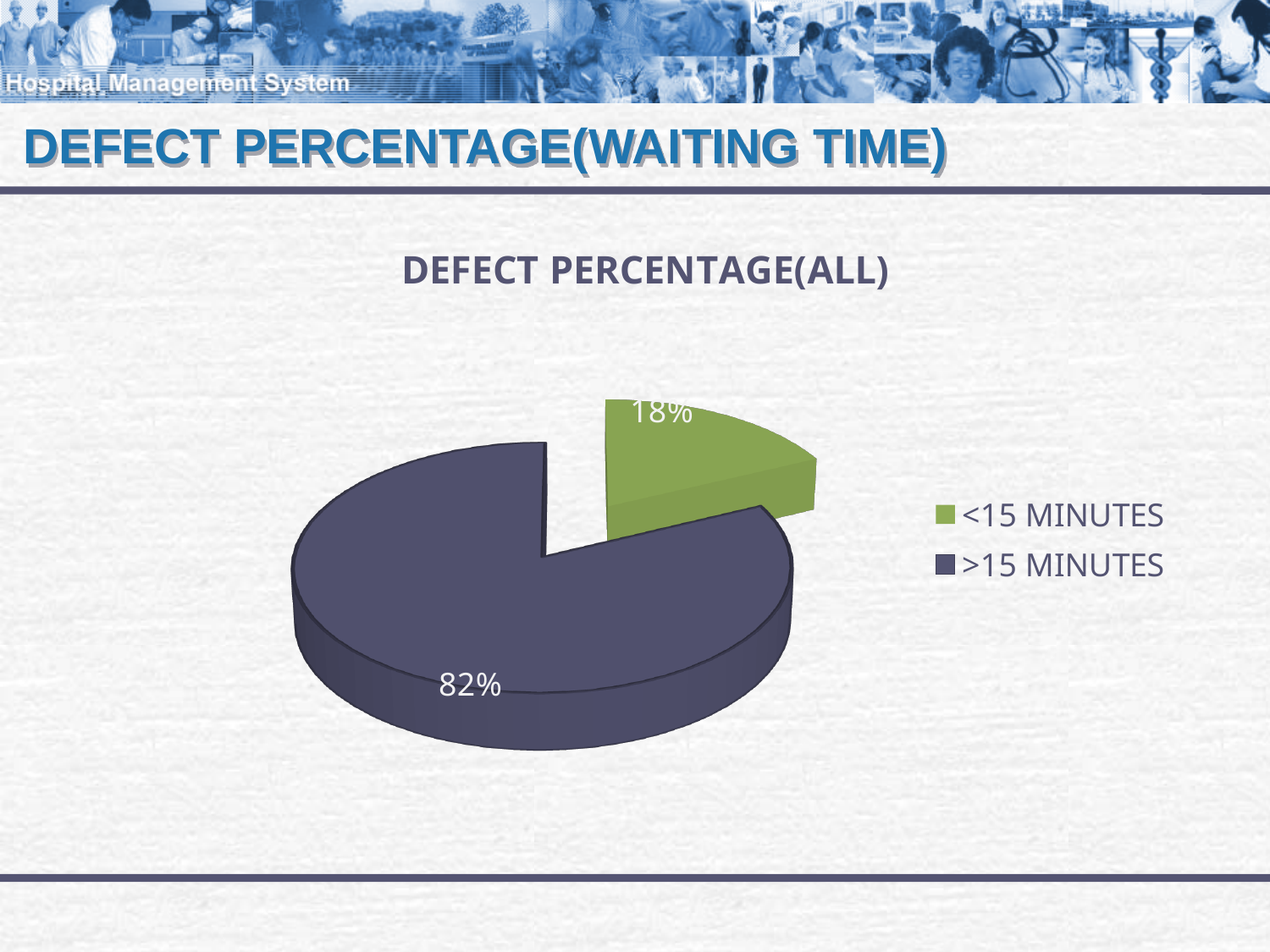
What is the title of the chart? DEFECT PERCENTAGE(ALL) How many entries does the legend list? 2 Which is larger, the <15 MINUTES slice or the >15 MINUTES slice? >15 MINUTES What colour is the <15 MINUTES slice? Green What percentage of the pie is the >15 MINUTES slice? 82% What percentage of the pie is the <15 MINUTES slice? 18% Which category has the largest share of the pie? >15 MINUTES What is the difference in percentage points between the >15 MINUTES slice and the <15 MINUTES slice? 64 How many slices does the pie chart have? 2 What kind of chart is shown on the slide? Pie chart Which category has the smallest share of the pie? <15 MINUTES